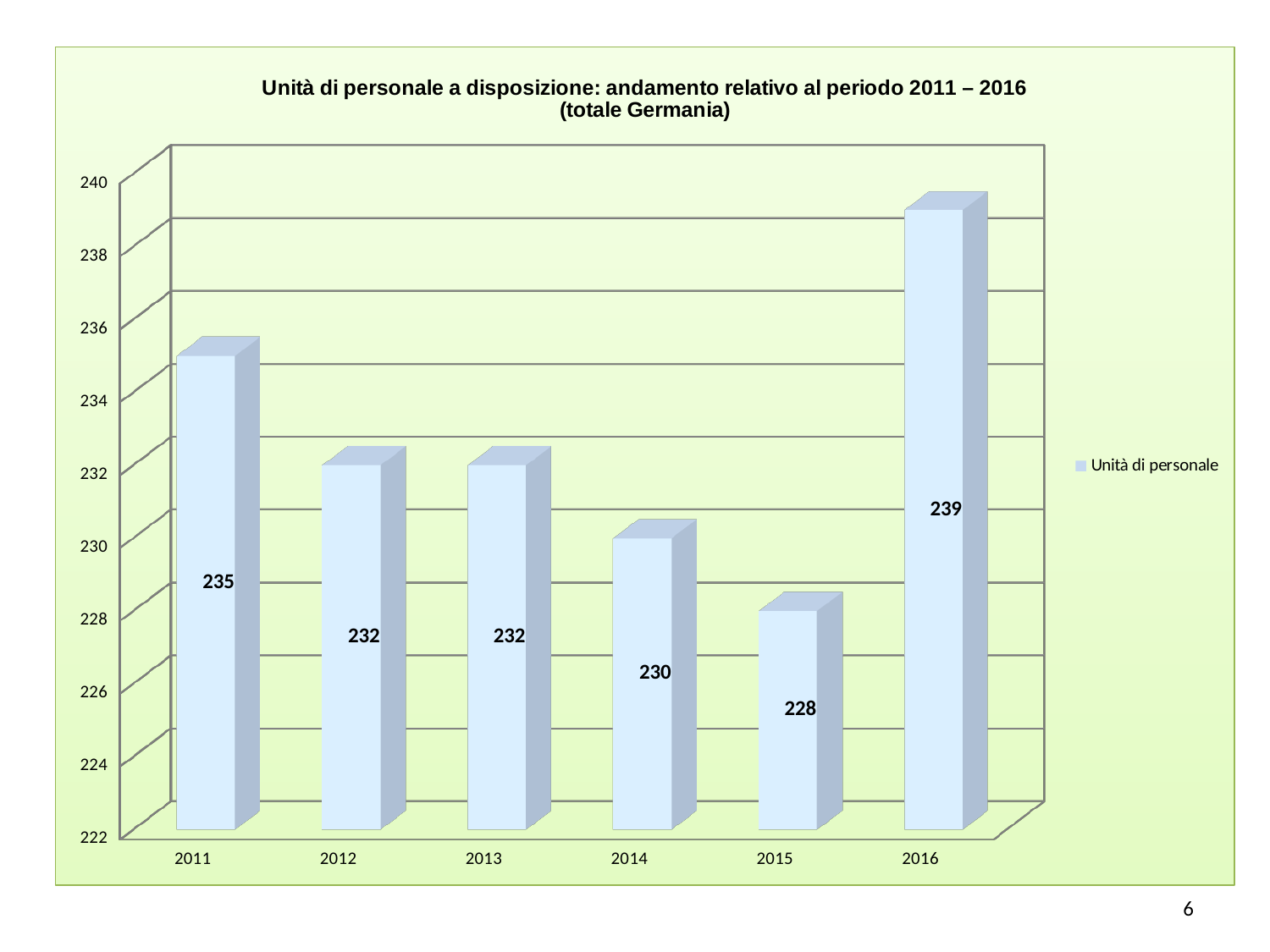
What kind of chart is this? bar chart What is the difference between the values for 2011 and 2012? 3 What is the value for 2011? 235 What is the value for 2015? 228 What is the difference between the values for 2016 and 2015? 11 What is the name of the series listed in the legend? Unità di personale Which is larger, the value for 2011 or the value for 2014? 2011 Is the value for 2016 greater or less than 238? greater Which year has the highest value? 2016 Which year has the lowest value? 2015 How many years are shown on the x axis? 6 What is the value for 2014? 230